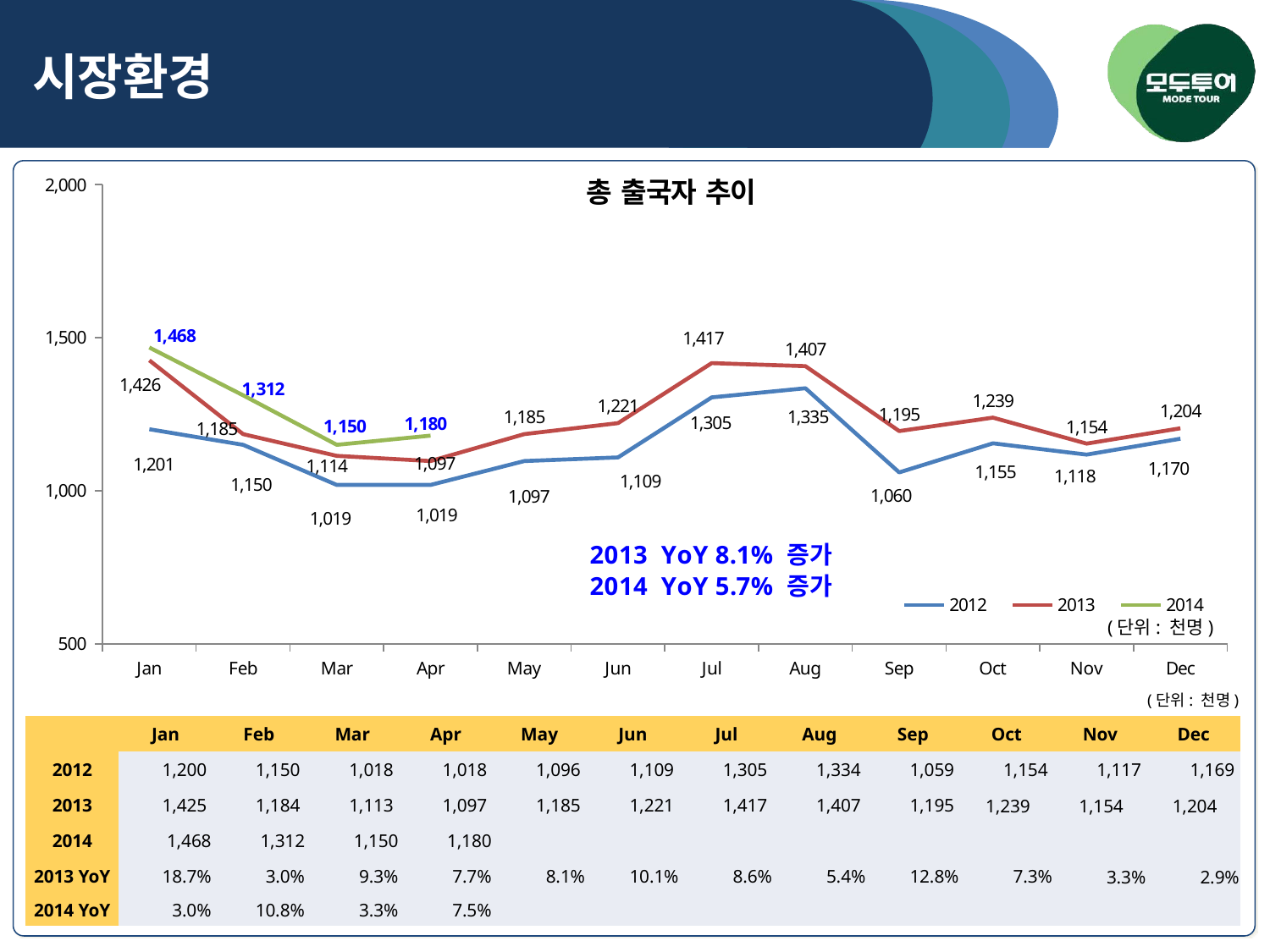
What is the value for the 2013 series in Jul? 1,417 How many series does the legend of the chart list? 3 What is the difference between the 2014 and 2013 values in Jan? 42 What is the value for the 2012 series in Sep? 1,060 What is the value for the 2014 series in Jan? 1,468 How many months are shown on the x axis of the chart? 12 What is the title of the chart? 총 출국자 추이 In which month does the 2013 series reach its lowest value? Apr What kind of chart is shown on the slide? line chart Which is larger for the 2013 series: the Jul value or the Aug value? Jul What is the difference between the 2013 and 2012 values in Jul? 112 In which month does the 2012 series reach its highest value? Aug